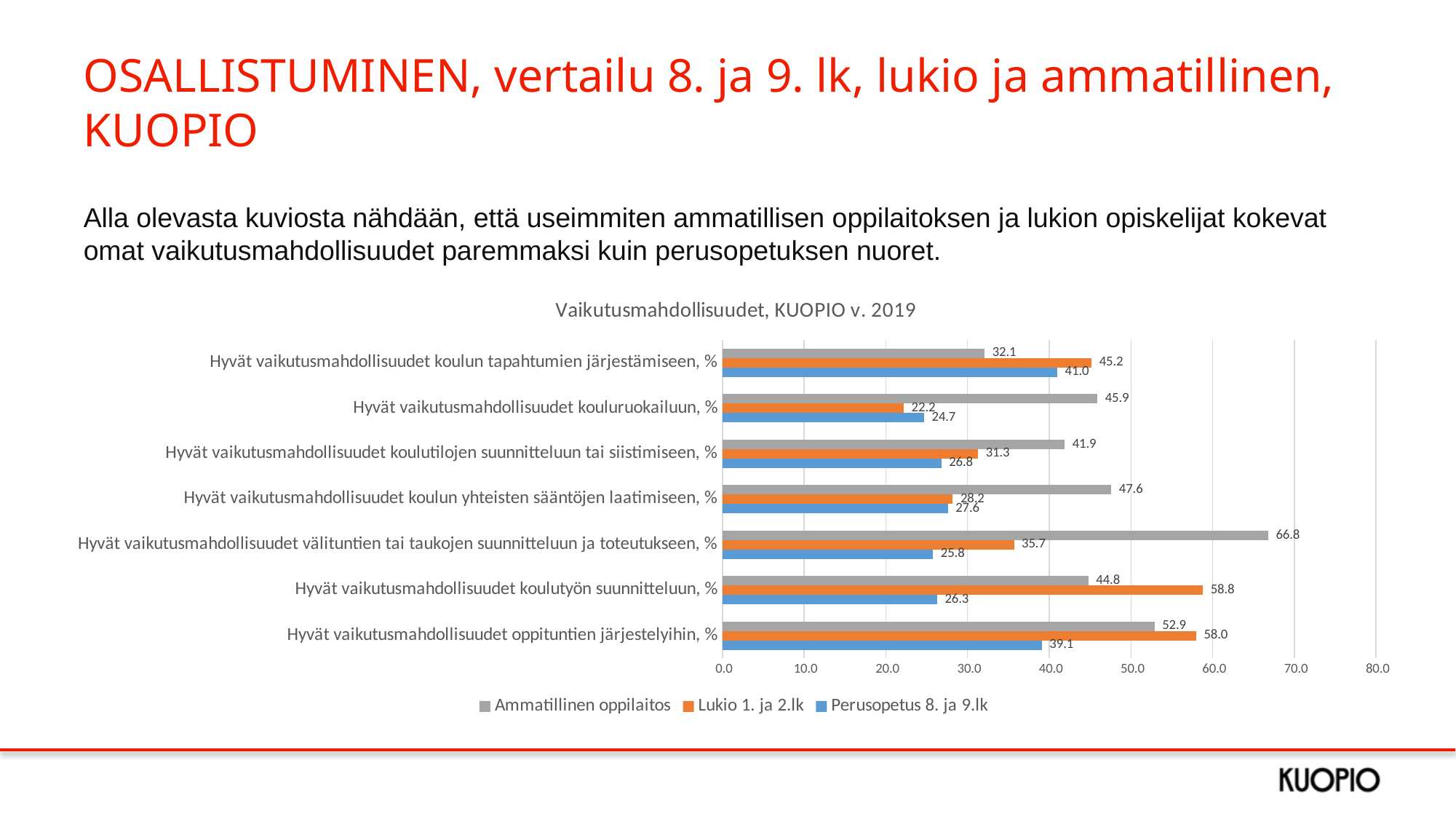
What is the value for Lukio 1. ja 2.lk in the category 'Hyvät vaikutusmahdollisuudet kouluruokailuun, %'? 22.2 What is the difference between the Lukio 1. ja 2.lk and Perusopetus 8. ja 9.lk values in the category 'Hyvät vaikutusmahdollisuudet koulutyön suunnitteluun, %'? 32.5 How many series does the legend list? 3 What is the value for Ammatillinen oppilaitos in the category 'Hyvät vaikutusmahdollisuudet välituntien tai taukojen suunnitteluun ja toteutukseen, %'? 66.8 How many categories are shown on the chart? 7 What type of chart is shown on the slide? Bar chart Which category has the lowest value for Lukio 1. ja 2.lk? Hyvät vaikutusmahdollisuudet kouluruokailuun, % In the category 'Hyvät vaikutusmahdollisuudet koulun tapahtumien järjestämiseen, %', which is larger: the value for Lukio 1. ja 2.lk or for Ammatillinen oppilaitos? Lukio 1. ja 2.lk What is the title of the chart? Vaikutusmahdollisuudet, KUOPIO v. 2019 What is the value for Perusopetus 8. ja 9.lk in the category 'Hyvät vaikutusmahdollisuudet oppituntien järjestelyihin, %'? 39.1 Which category has the highest value for Ammatillinen oppilaitos? Hyvät vaikutusmahdollisuudet välituntien tai taukojen suunnitteluun ja toteutukseen, % Which series is shown in orange in the chart? Lukio 1. ja 2.lk